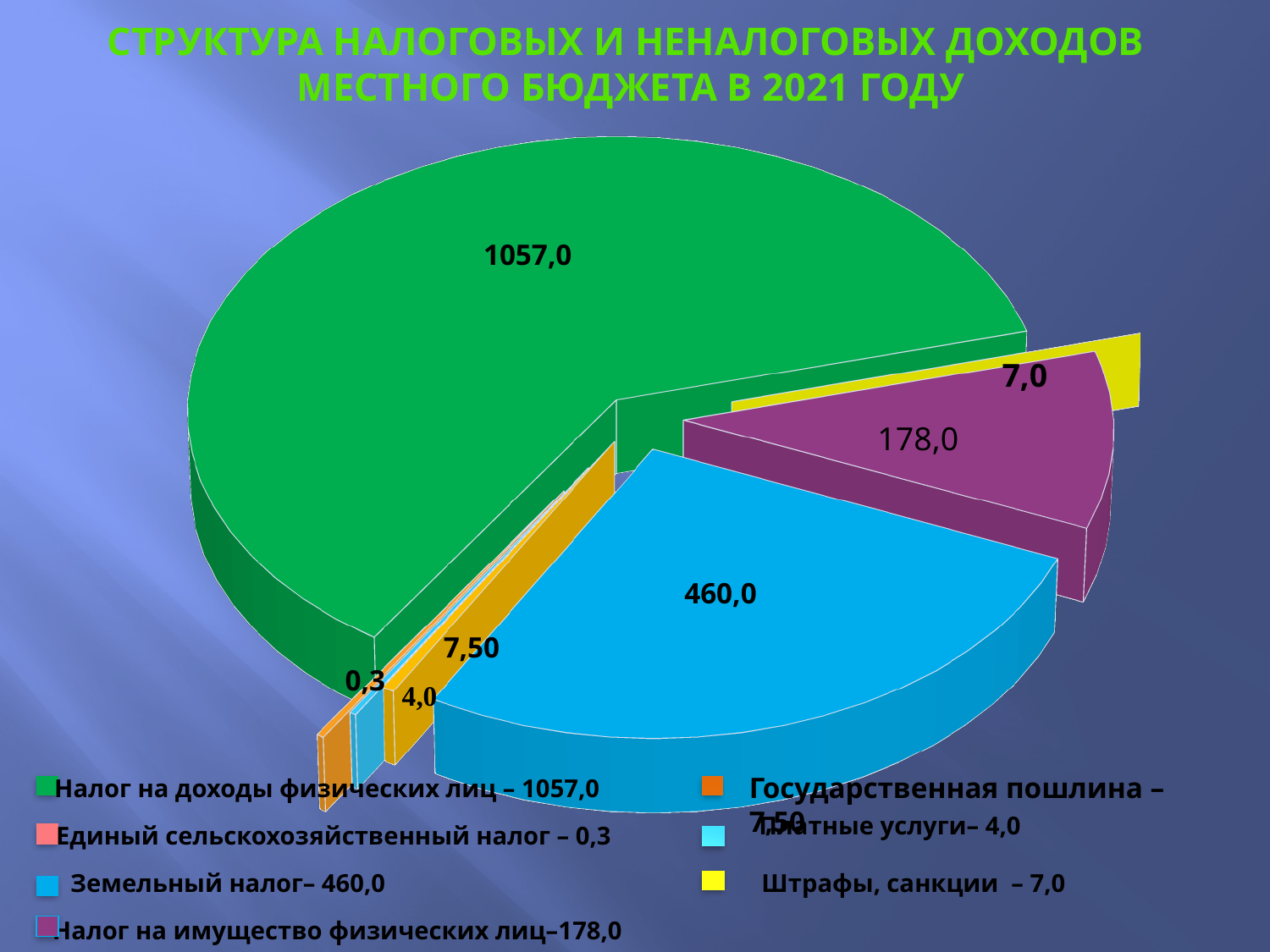
What is the value for Налог на доходы физических лиц? 1057,0 What is the value for Земельный налог? 460,0 What is the title of the chart on the slide? СТРУКТУРА НАЛОГОВЫХ И НЕНАЛОГОВЫХ ДОХОДОВ МЕСТНОГО БЮДЖЕТА В 2021 ГОДУ Which is larger: Государственная пошлина or Штрафы, санкции? Государственная пошлина How many categories does the pie chart show? 7 What is the difference between the values for Налог на доходы физических лиц and Земельный налог? 597,0 Which category has the smallest value? Единый сельскохозяйственный налог Which category has the largest slice of the pie? Налог на доходы физических лиц What is the value for Налог на имущество физических лиц? 178,0 What is the value for Государственная пошлина? 7,50 What type of chart is shown on the slide? pie chart What is the value for Платные услуги? 4,0